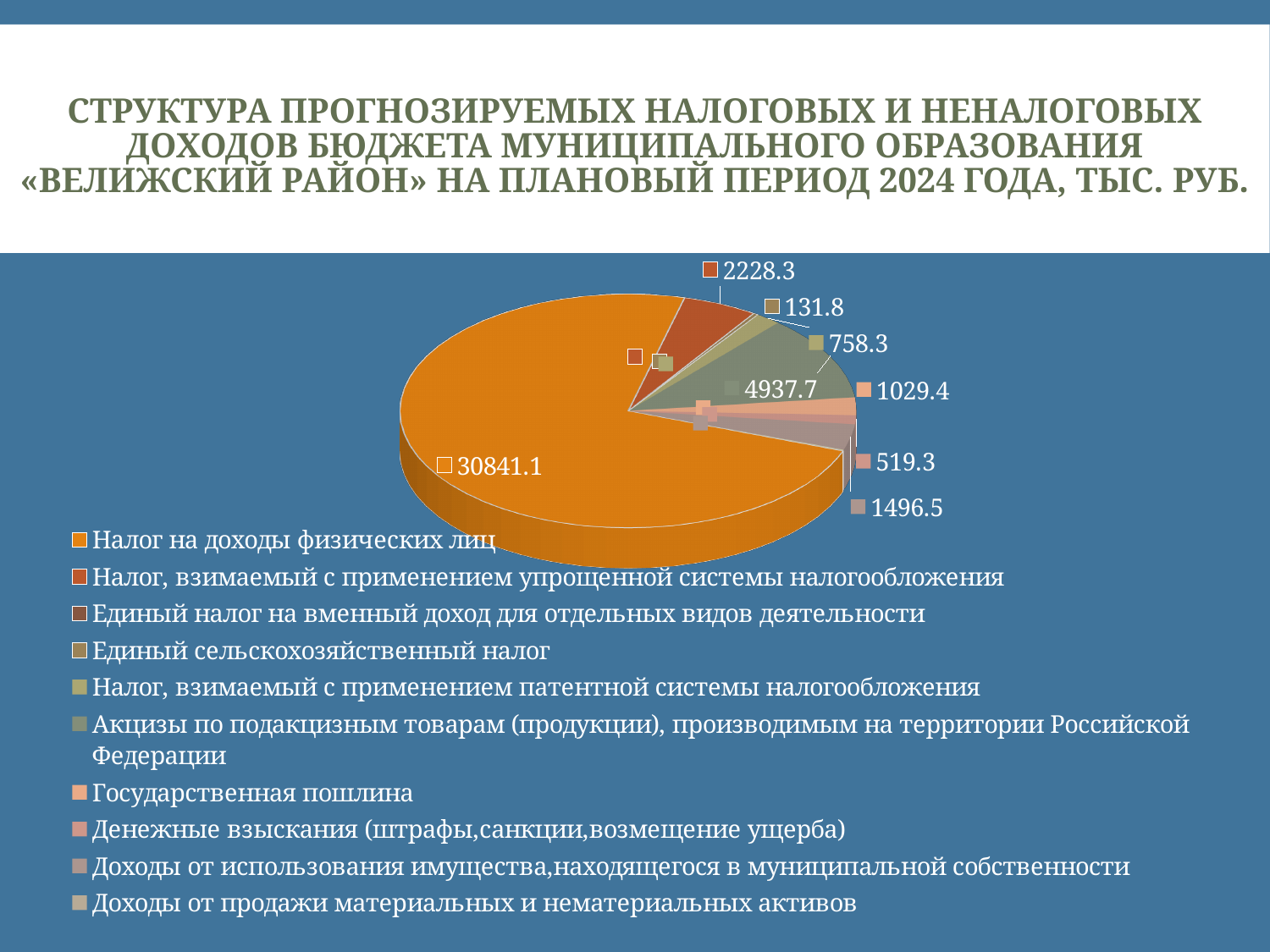
Which category has the largest slice in the pie chart? Налог на доходы физических лиц What value is shown for 'Акцизы по подакцизным товарам (продукции), производимым на территории Российской Федерации'? 4937.7 What value is shown for 'Денежные взыскания (штрафы,санкции,возмещение ущерба)'? 519.3 What kind of chart is shown on the slide? Pie chart In what units are the values in the chart expressed, according to the slide title? тыс. руб. What value is shown for 'Налог, взимаемый с применением упрощенной системы налогообложения'? 2228.3 How many categories does the legend of the pie chart list? 10 Which is larger: the value for 'Государственная пошлина' or the value for 'Денежные взыскания (штрафы,санкции,возмещение ущерба)'? Государственная пошлина What value is shown for 'Государственная пошлина'? 1029.4 What value is shown for 'Доходы от использования имущества,находящегося в муниципальной собственности'? 1496.5 What is the difference between the value for 'Налог на доходы физических лиц' (30841.1) and the value for 'Акцизы по подакцизным товарам' (4937.7)? 25903.4 What is the value shown for the largest slice of the pie chart? 30841.1